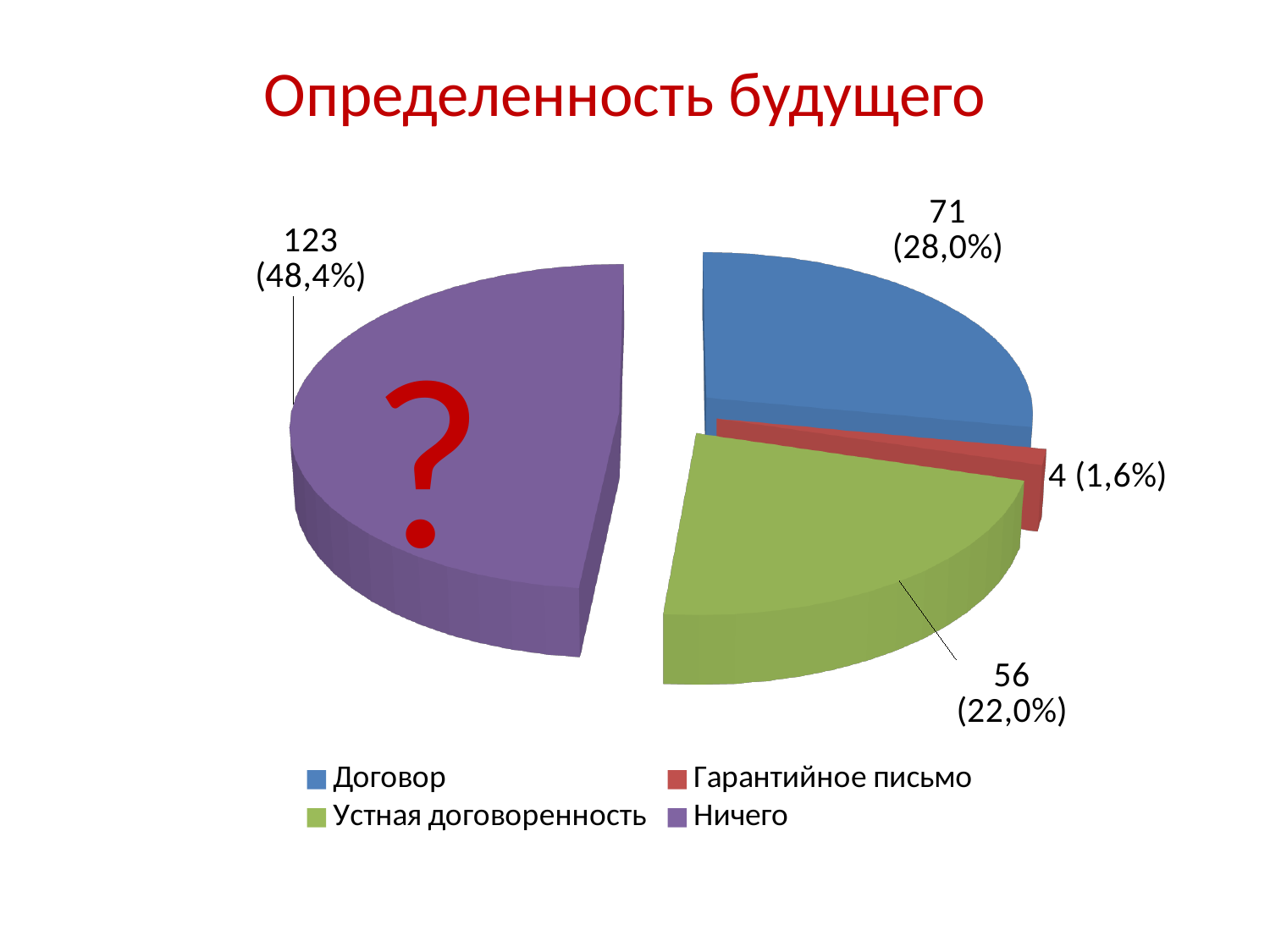
How many categories does the legend list? 4 What is the difference between the values for Ничего and Договор? 52 What is the value for Гарантийное письмо? 4 Which category has the largest slice? Ничего Which category has the smallest slice? Гарантийное письмо What is the value for Договор? 71 What share of the pie does Устная договоренность represent? 22,0% What is the value for Ничего? 123 Which is larger, the value for Договор or the value for Устная договоренность? Договор What kind of chart is shown on the slide? pie chart What is the value for Устная договоренность? 56 What share of the pie does Ничего represent? 48,4%